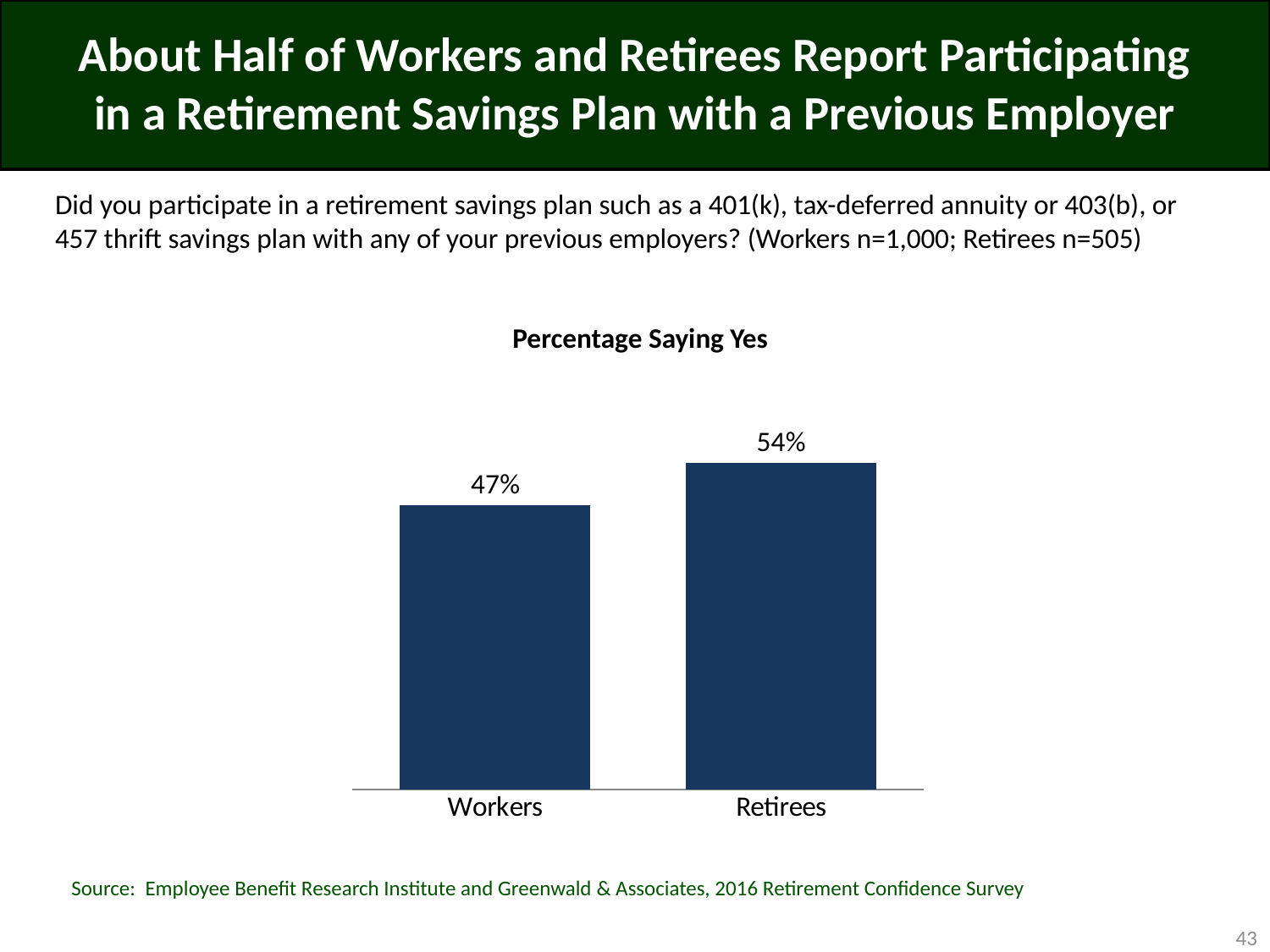
What percentage of Workers said yes? 47% Do the values rise or fall from Workers to Retirees? rise What is the difference in percentage points between Retirees and Workers? 7 percentage points Is the value for Workers larger or smaller than the value for Retirees? smaller What kind of chart is shown on the slide? bar chart What colour are the bars in the chart? dark blue What percentage of Retirees said yes? 54% Which group has the lower percentage saying yes? Workers What is the title of the chart? Percentage Saying Yes Which group has the higher percentage saying yes? Retirees How many categories are shown on the chart? 2